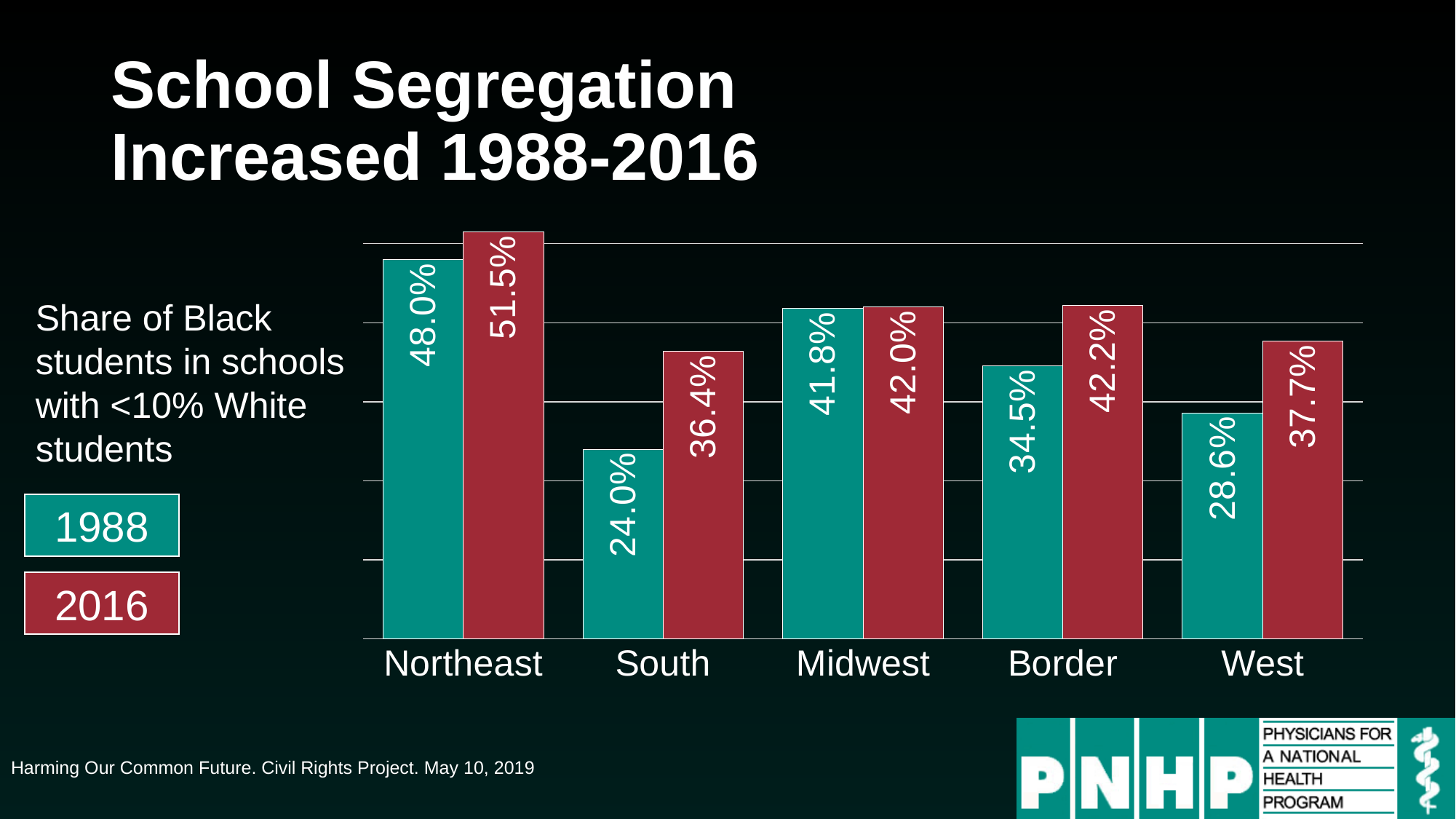
Which is larger: the 2016 value for the Border region or the 2016 value for the Midwest? Border What was the 1988 value for the Border region? 34.5% What is the difference between the 2016 and 1988 values for the West? 9.1 percentage points What was the share of Black students in schools with <10% White students in the South in 1988? 24.0% What was the 2016 value for the West? 37.7% Which colour represents the year 2016 in the chart? Red Which region had the highest value in 2016? Northeast What type of chart is shown on the slide? Bar chart Which region had the lowest value in 1988? South By how many percentage points did the South's value increase from 1988 to 2016? 12.4 percentage points How many series (years) does the legend list? 2 How many regions are shown on the x axis? 5